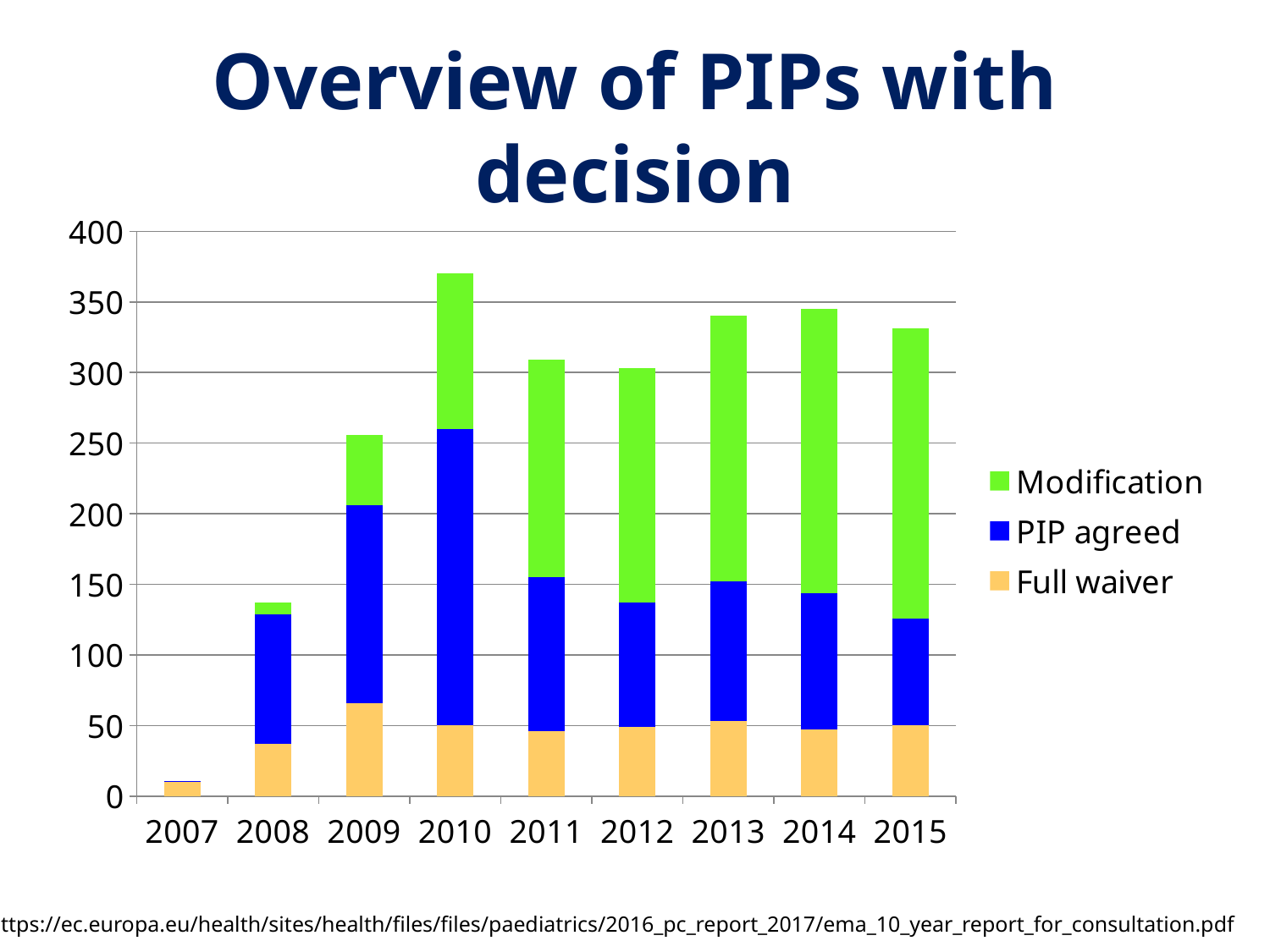
Is the Full waiver value for 2009 greater or less than 50? greater What kind of chart is shown on the slide? Stacked bar chart Which year has the highest total bar? 2010 Which year has the lowest total bar? 2007 Is the total for 2015 greater or less than 300? greater Is the total for 2010 greater or less than 350? greater How many series does the legend list? 3 Which year has the larger total bar, 2009 or 2010? 2010 Do the total bar heights rise or fall from 2007 to 2010? rise Which series is shown in green? Modification How many years are shown on the x axis? 9